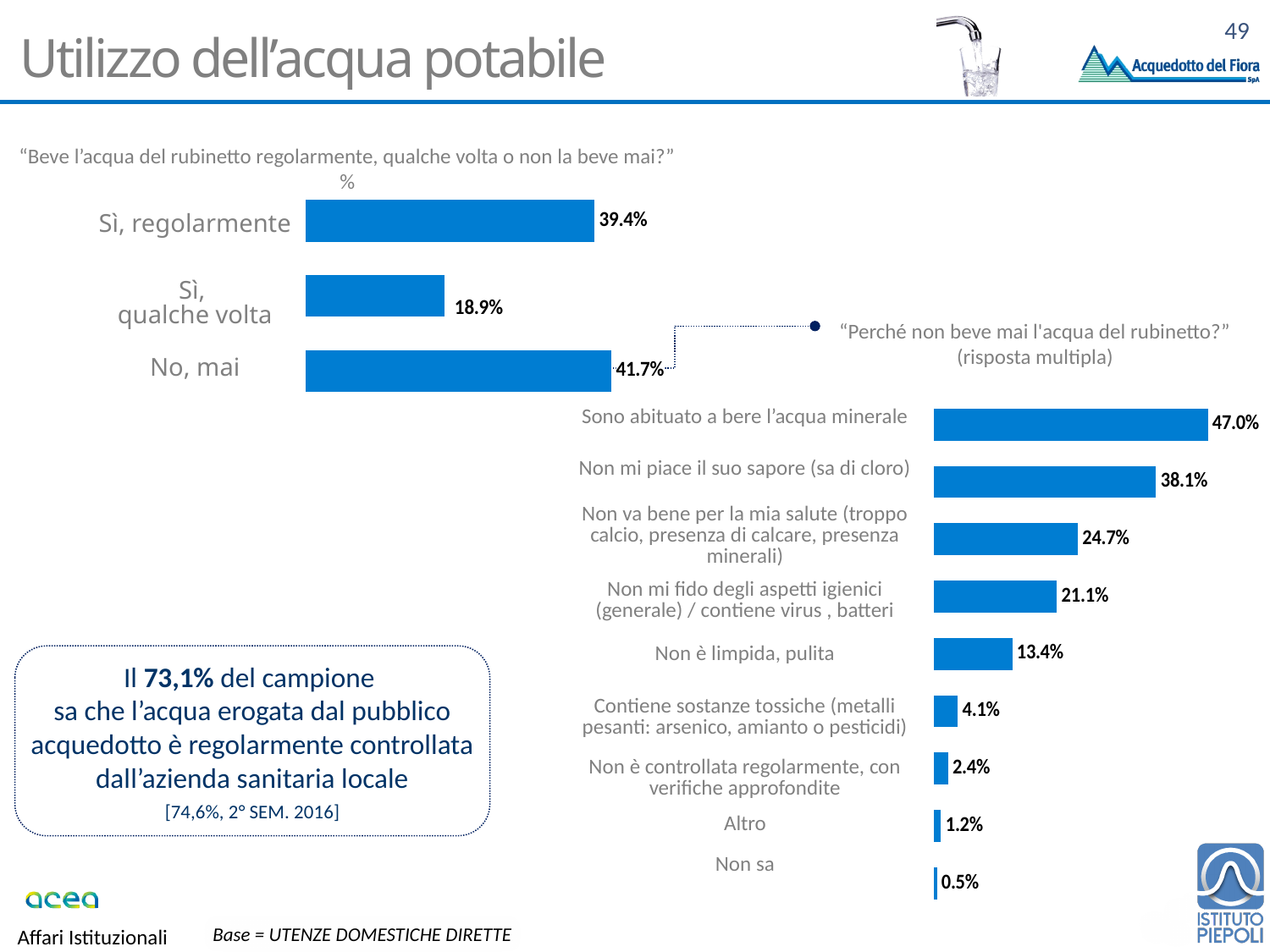
In the chart "Beve l'acqua del rubinetto regolarmente, qualche volta o non la beve mai?", which category has the lowest value? Sì, qualche volta In the chart "Perché non beve mai l'acqua del rubinetto?", which is larger: "Non mi piace il suo sapore (sa di cloro)" or "Non mi fido degli aspetti igienici (generale) / contiene virus, batteri"? Non mi piace il suo sapore (sa di cloro) In the chart "Perché non beve mai l'acqua del rubinetto?", what is the value for "Sono abituato a bere l'acqua minerale"? 47.0% In the chart "Perché non beve mai l'acqua del rubinetto?", which category has the lowest value? Non sa In the chart "Beve l'acqua del rubinetto regolarmente, qualche volta o non la beve mai?", what is the value for "Sì, qualche volta"? 18.9% In the chart "Perché non beve mai l'acqua del rubinetto?", what is the value for "Non è limpida, pulita"? 13.4% In the chart "Beve l'acqua del rubinetto regolarmente, qualche volta o non la beve mai?", how many categories are shown? 3 In the chart "Perché non beve mai l'acqua del rubinetto?", how many categories are shown? 9 What kind of chart is "Perché non beve mai l'acqua del rubinetto?"? Bar chart In the chart "Beve l'acqua del rubinetto regolarmente, qualche volta o non la beve mai?", what is the value for "Sì, regolarmente"? 39.4% In the chart "Perché non beve mai l'acqua del rubinetto?", what is the difference between "Sono abituato a bere l'acqua minerale" and "Non mi piace il suo sapore (sa di cloro)"? 8.9% In the chart "Beve l'acqua del rubinetto regolarmente, qualche volta o non la beve mai?", what is the difference between "No, mai" and "Sì, regolarmente"? 2.3%